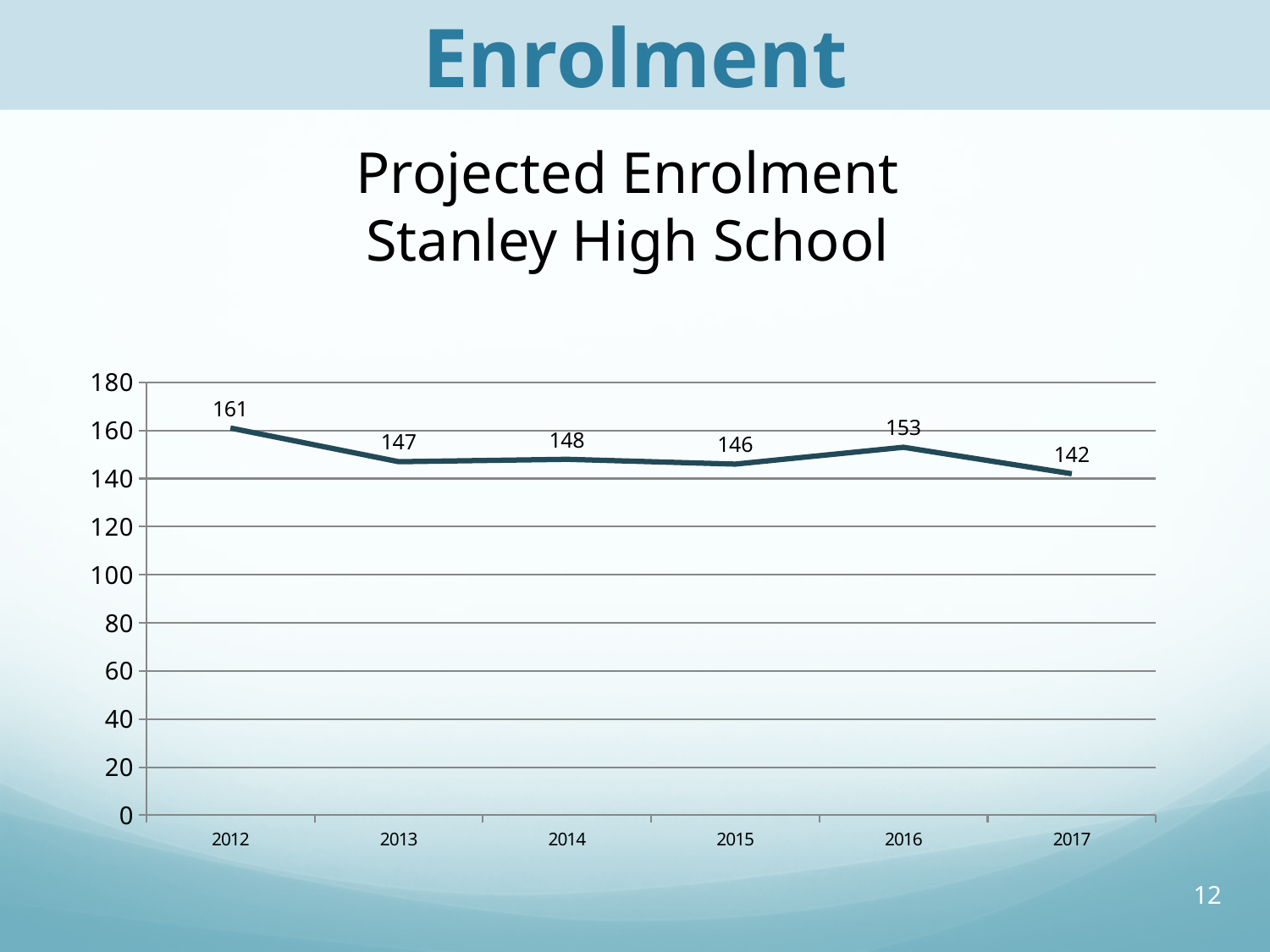
What is the difference between the projected enrolment in 2012 and in 2017? 19 What is the projected enrolment for 2017? 142 What kind of chart is shown on the slide? line chart How many years are plotted on the chart? 6 Is the projected enrolment for 2015 greater or less than 160? less What is the title of the chart? Projected Enrolment Stanley High School Which year has the lowest projected enrolment? 2017 What is the projected enrolment for 2016? 153 Which year has the highest projected enrolment? 2012 Which year has a larger projected enrolment, 2013 or 2016? 2016 What is the projected enrolment for 2012? 161 What is the difference between the projected enrolment in 2016 and in 2015? 7